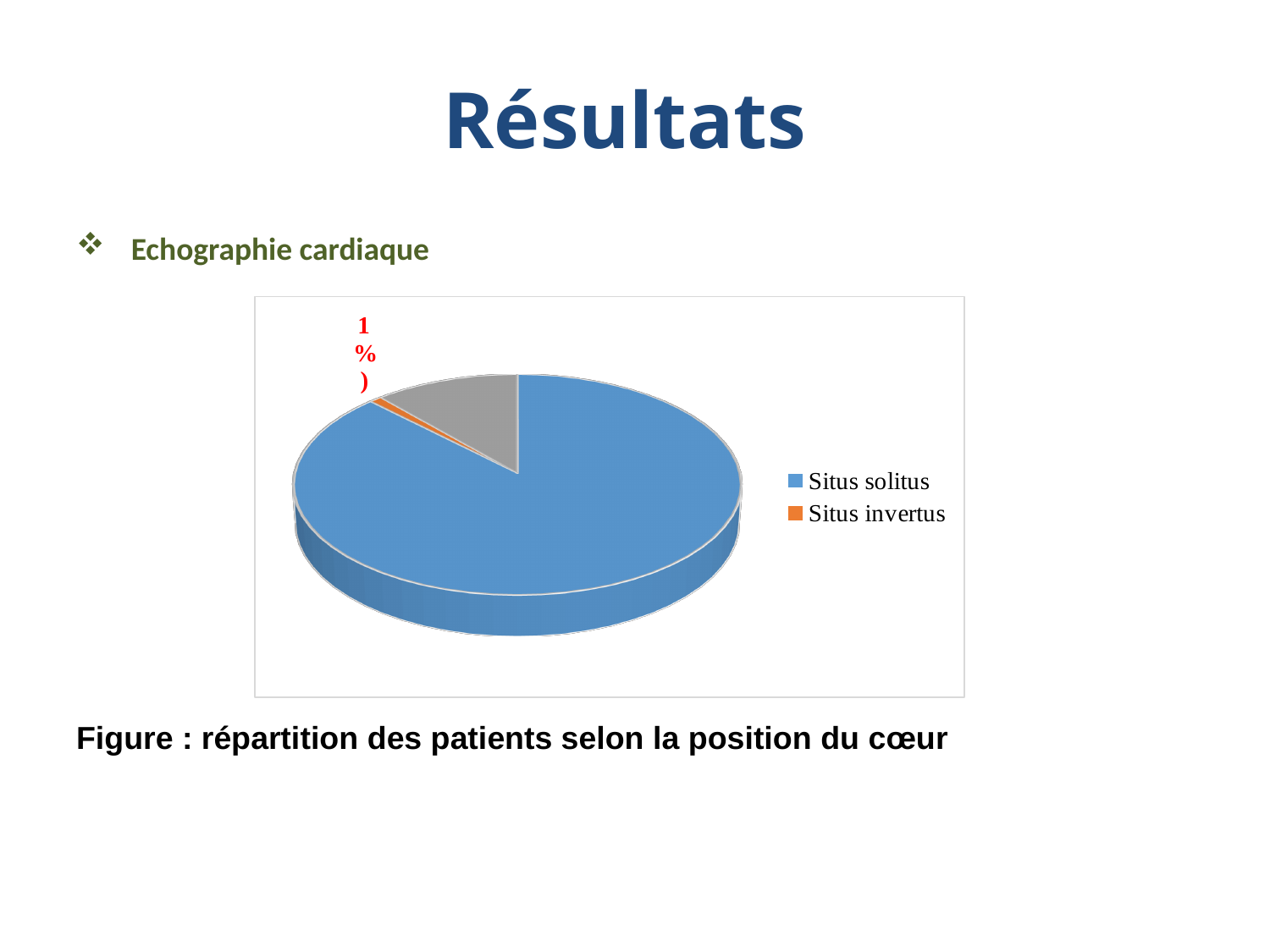
What colour is the Situs solitus slice? blue How many entries does the chart's legend list? 2 What colour is the Situs invertus slice? orange Which of the legend categories has the smallest slice of the pie? Situs invertus Which category has the largest slice of the pie? Situs solitus What kind of chart is shown on the slide? pie chart Which slice is larger, Situs solitus or Situs invertus? Situs solitus